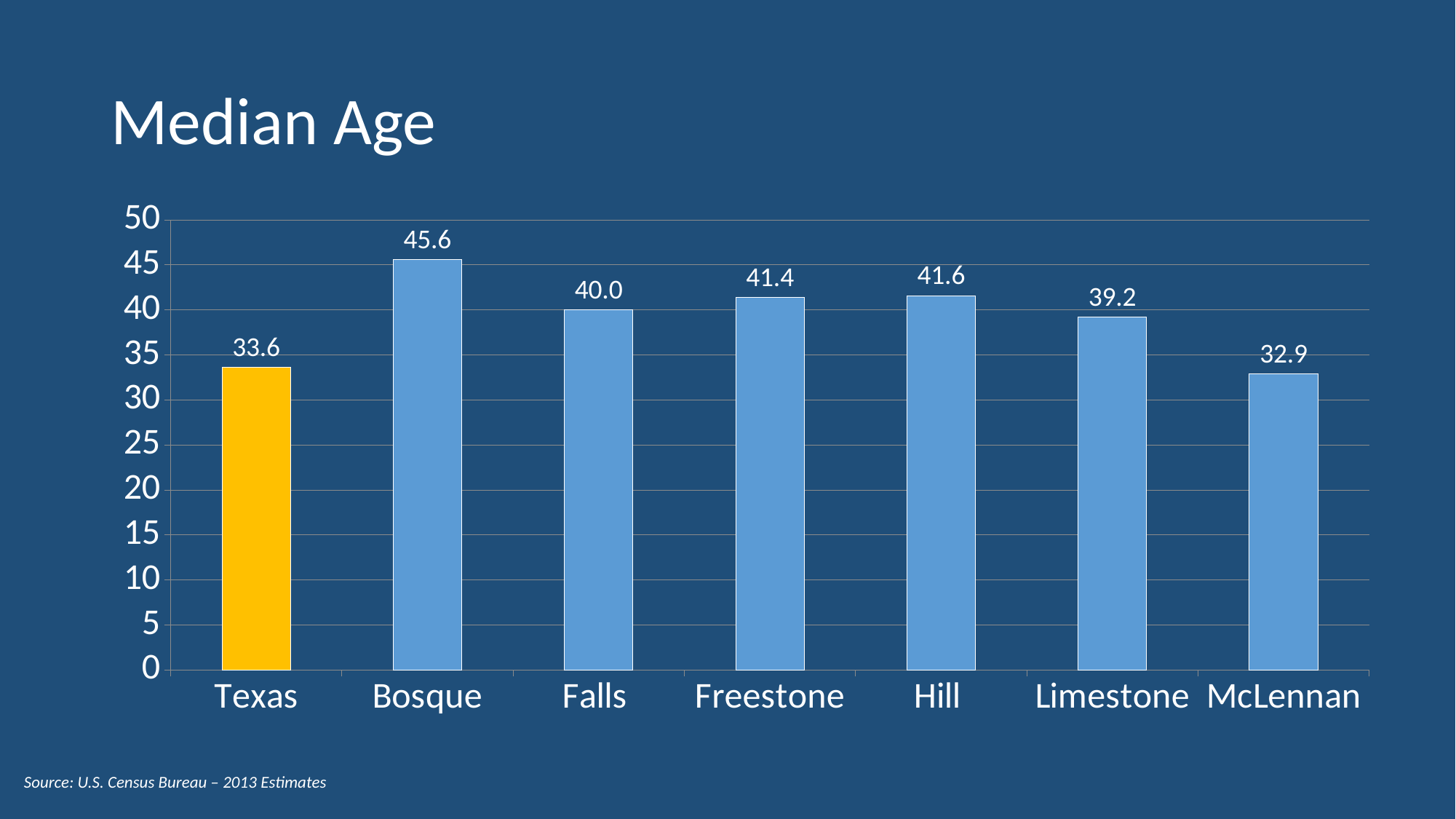
What is the difference between the median age for Bosque and the median age for Texas? 12.0 How many categories are shown on the x axis? 7 Which category has the highest median age? Bosque What kind of chart is shown on the slide? bar chart What is the median age shown for Bosque? 45.6 What is the difference between the median age for Hill and the median age for Falls? 1.6 What is the median age shown for Limestone? 39.2 What is the median age shown for McLennan? 32.9 Which category has the lowest median age? McLennan Which has a higher median age, Freestone or Limestone? Freestone Is the value for Falls greater or less than 35? greater What is the median age shown for Texas? 33.6